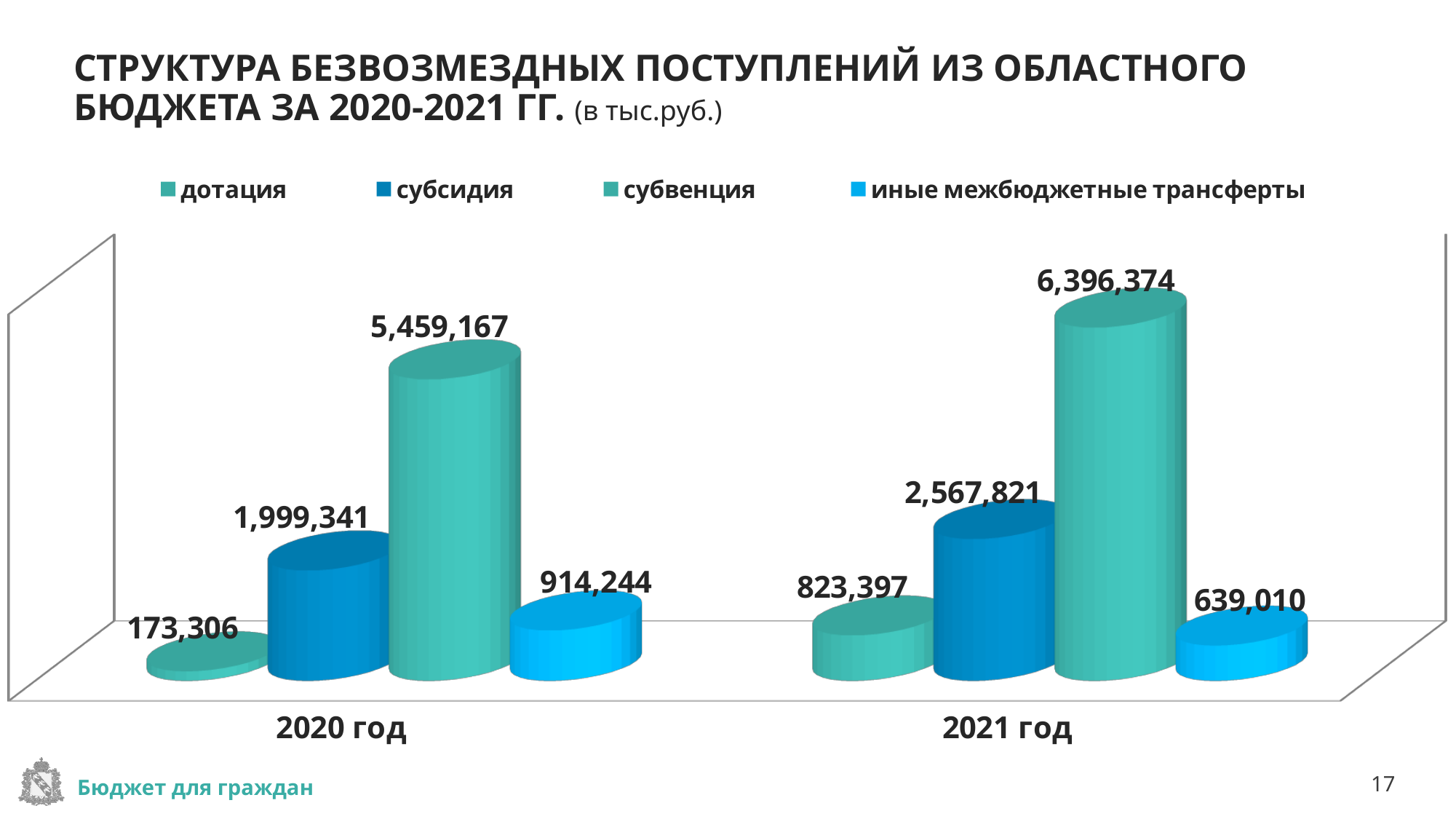
What is the difference between the субсидия values for 2021 год and 2020 год? 568,480 What kind of chart is shown on the slide? Bar chart What is the value for субсидия in 2021 год? 2,567,821 How many series does the legend list? 4 Which is larger: иные межбюджетные трансферты in 2020 год or in 2021 год? 2020 год Which series has the highest value in 2021 год? субвенция What is the value for дотация in 2021 год? 823,397 What is the difference between the субвенция values for 2021 год and 2020 год? 937,207 What is the value for субвенция in 2020 год? 5,459,167 How many year categories are shown on the x axis? 2 Which series has the lowest value in 2020 год? дотация What is the value for иные межбюджетные трансферты in 2020 год? 914,244